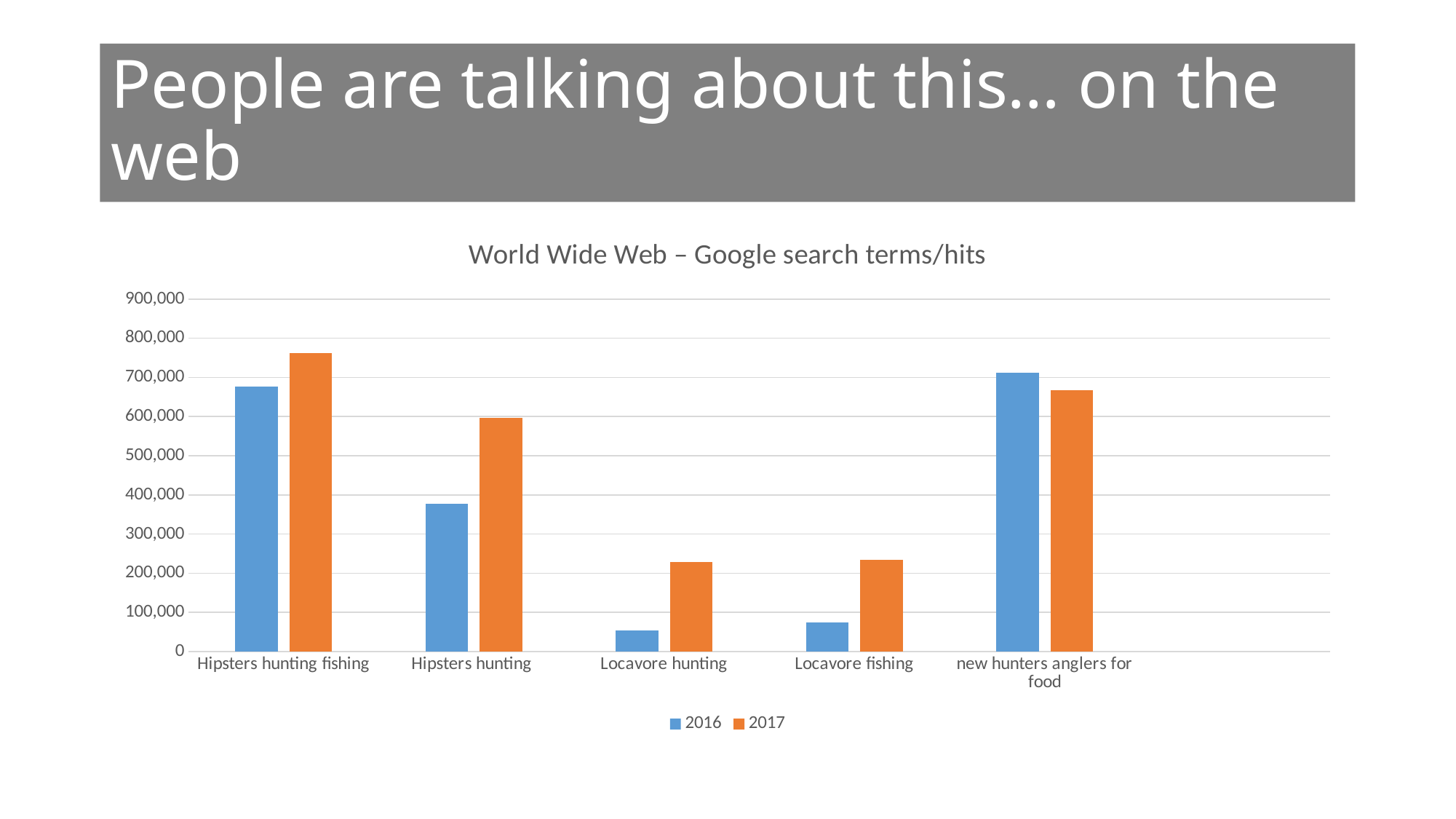
Is the 2016 value for Locavore hunting greater or less than 100,000? less How many search-term categories are shown on the x axis? 5 Which category has the highest value for 2017? Hipsters hunting fishing For Hipsters hunting, which year has the larger value, 2016 or 2017? 2017 Is the 2017 value for Locavore fishing greater or less than 200,000? greater Which category has the lowest value for 2016? Locavore hunting Is the 2017 value for Hipsters hunting greater or less than 500,000? greater What is the title of the chart? World Wide Web – Google search terms/hits For new hunters anglers for food, which year has the larger value, 2016 or 2017? 2016 How many series does the legend list? 2 What kind of chart is shown on the slide? bar chart